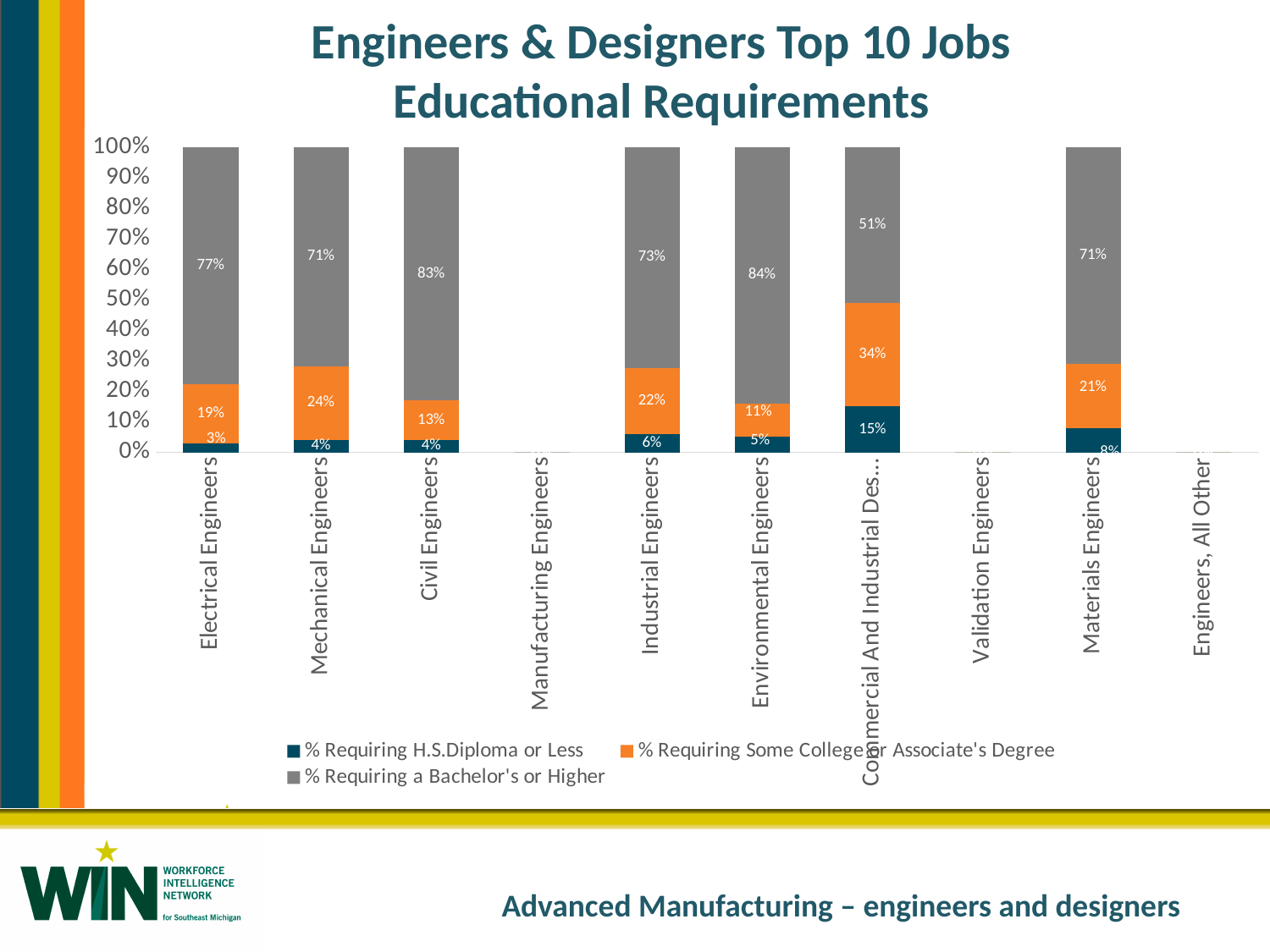
What percentage of Electrical Engineers jobs require a Bachelor's or Higher? 77% How many percentage points higher is the Bachelor's or Higher share for Civil Engineers than for Mechanical Engineers? 12 percentage points How many series does the legend list? 3 How many job categories are listed on the x axis? 10 What percentage of Environmental Engineers jobs require H.S. Diploma or Less? 5% Among the jobs with labeled bars, which has the lowest percentage requiring Some College or Associate's Degree? Environmental Engineers Which has a larger share requiring Some College or Associate's Degree: Electrical Engineers or Industrial Engineers? Industrial Engineers Which job has the highest percentage requiring a Bachelor's or Higher? Environmental Engineers What percentage of Mechanical Engineers jobs require Some College or Associate's Degree? 24% What type of chart is shown on the slide? Stacked bar chart Which legend entry is shown in orange? % Requiring Some College or Associate's Degree What percentage of Industrial Engineers jobs require H.S. Diploma or Less? 6%